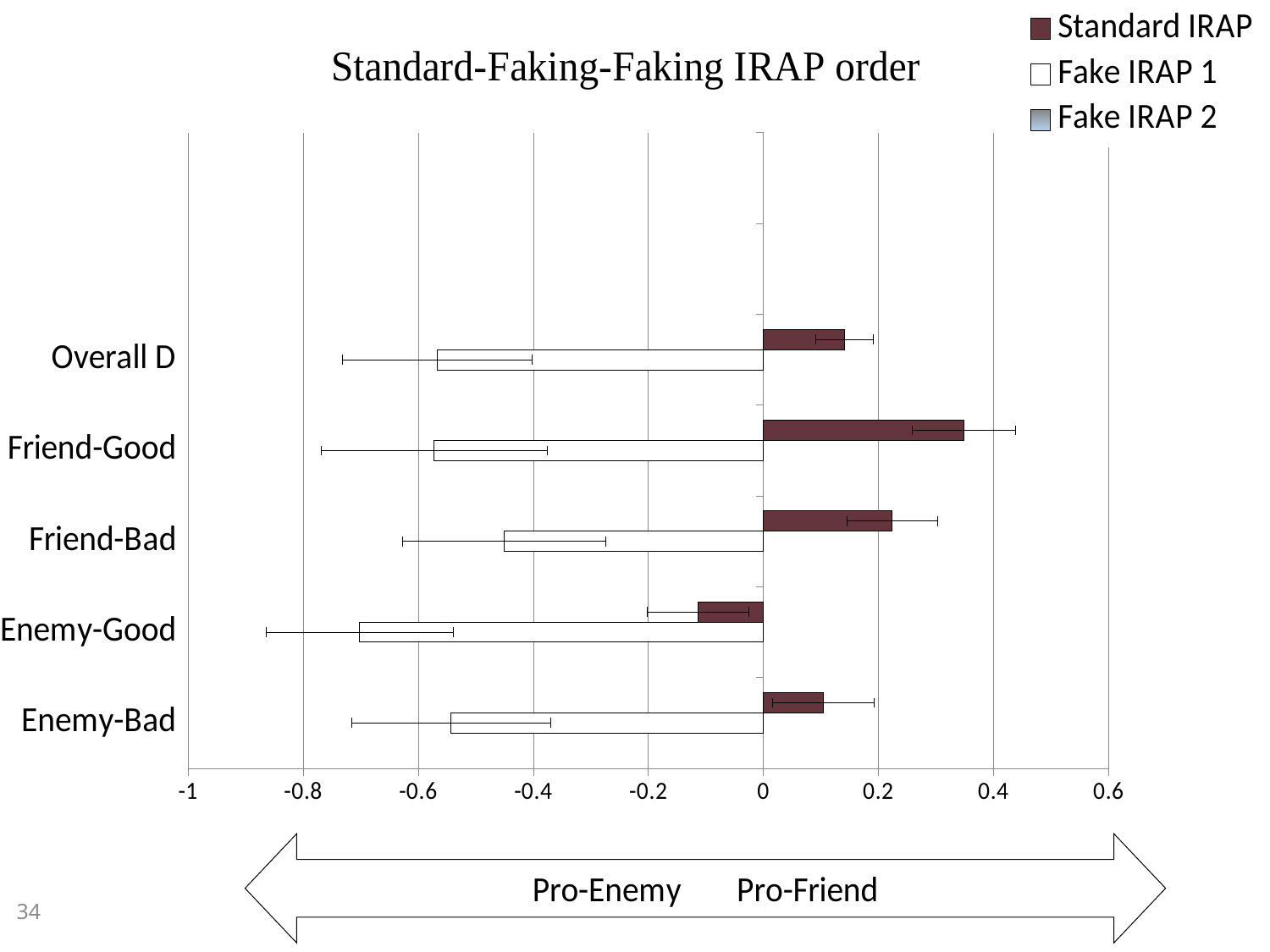
What is the title of the chart? Standard-Faking-Faking IRAP order What kind of chart is shown on the slide? bar chart Which category has the lowest Standard IRAP value? Enemy-Good Is the Fake IRAP 1 value for Enemy-Good greater or less than -0.6? less Is the Standard IRAP value for Friend-Good greater or less than 0.2? greater For Standard IRAP, which is larger: Friend-Good or Friend-Bad? Friend-Good How many series does the legend list? 3 How many categories are shown on the vertical axis of the chart? 5 Is the Standard IRAP value for Enemy-Good greater or less than 0? less Which category has the lowest (most negative) Fake IRAP 1 value? Enemy-Good Which category has the highest Standard IRAP value? Friend-Good For Overall D, which series has the larger value: Standard IRAP or Fake IRAP 1? Standard IRAP